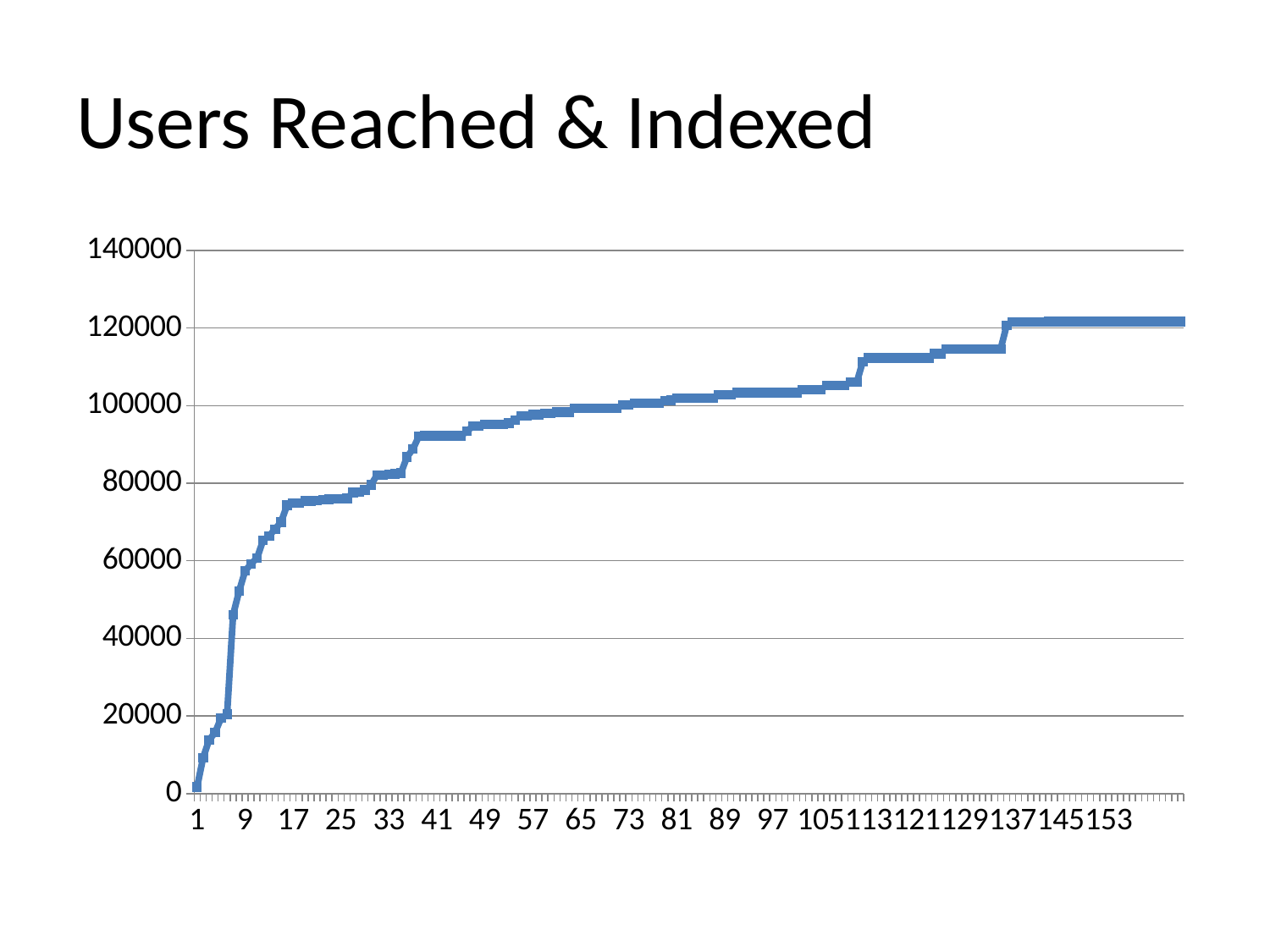
Do the values generally rise or fall as the x axis increases? rise How many lines are plotted on the chart? 1 Is the value at x = 113 greater or less than 100000? greater What is the highest value labelled on the y axis? 140000 Is the value at x = 1 greater or less than 20000? less What is the title of the chart? Users Reached & Indexed Is the value at x = 49 greater or less than 100000? less Which is larger, the value at x = 9 or the value at x = 137? x = 137 What kind of chart is shown on the slide? line chart